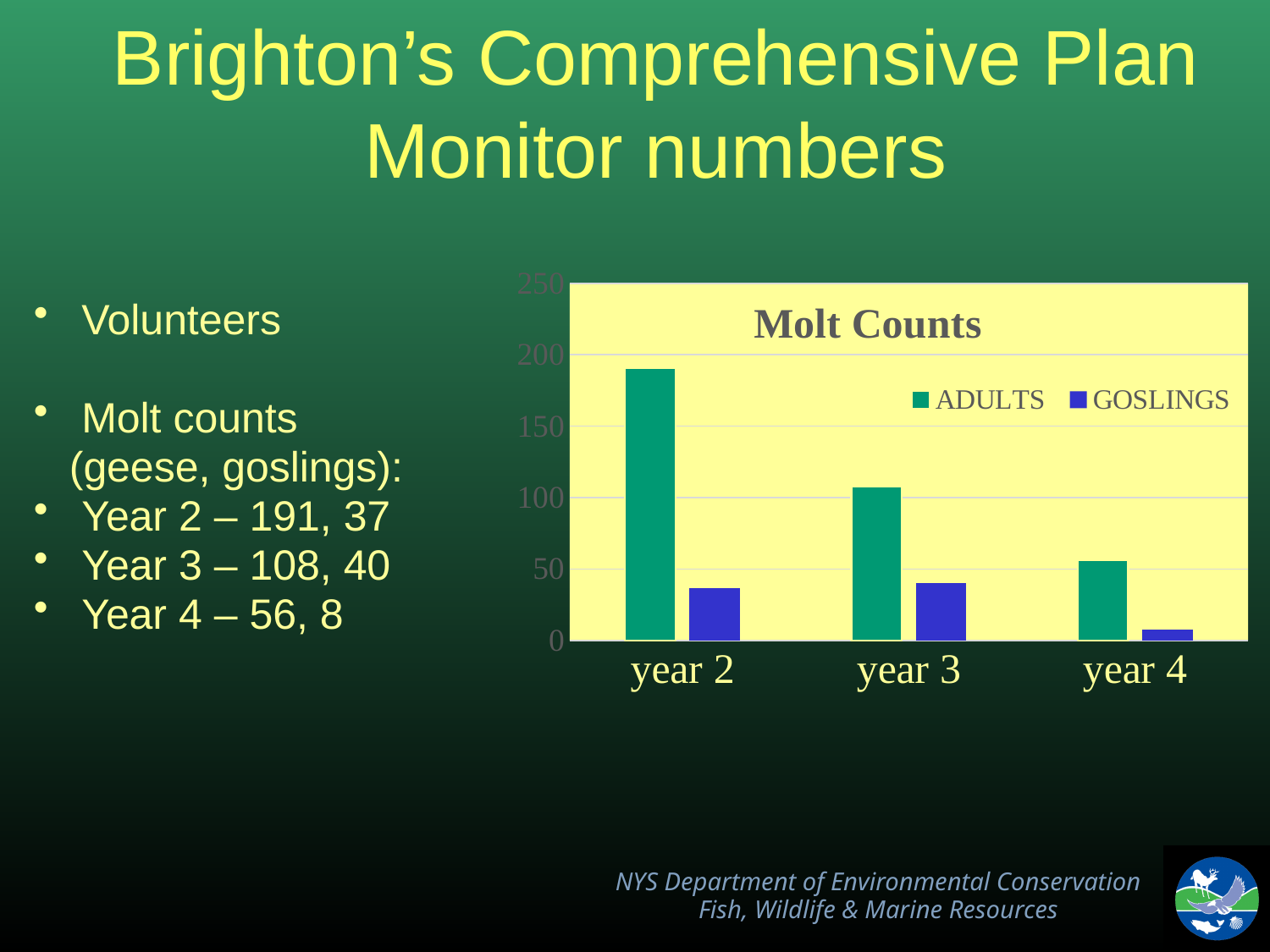
Is the GOSLINGS value for year 3 greater or less than 50? less In year 3, which is larger in the Molt Counts chart, ADULTS or GOSLINGS? ADULTS According to the slide, what is the difference between the adult and gosling molt counts in year 2? 154 How many year categories are shown on the x axis of the Molt Counts chart? 3 How many series does the legend of the Molt Counts chart list? 2 What is the title of the chart on the slide? Molt Counts What kind of chart is shown on the slide? bar chart According to the slide, what is the adult molt count for year 4? 56 Is the ADULTS value for year 2 greater or less than 150? greater In which year is the GOSLINGS bar lowest in the Molt Counts chart? year 4 In which year is the ADULTS bar highest in the Molt Counts chart? year 2 Do the ADULTS values rise or fall from year 2 to year 4 in the Molt Counts chart? fall